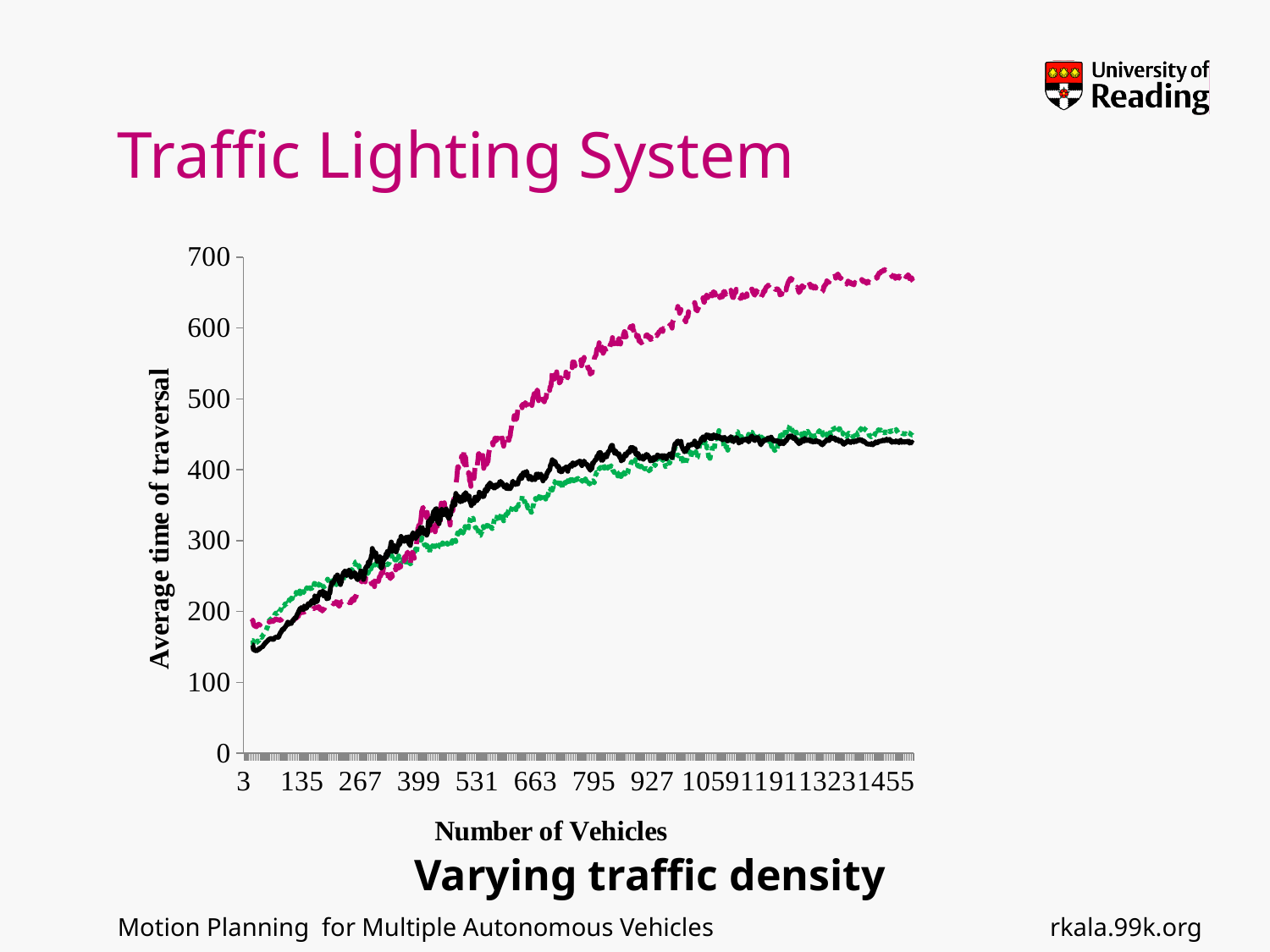
How many tick labels are shown on the x axis? 12 What is the title of the y axis? Average time of traversal Is the value of the green dotted line at 399 vehicles greater or less than 400? less Do the plotted values generally rise or fall as the number of vehicles increases? rise Is the value of the black solid line at 1455 vehicles greater or less than 500? less How many lines are plotted on the chart? 3 Is the value of the magenta dashed line at 1455 vehicles greater or less than 600? greater What is the title of the x axis? Number of Vehicles At 1455 vehicles, which is larger: the value of the magenta dashed line or the value of the black solid line? the magenta dashed line What kind of chart is shown on the slide? line chart Which line reaches the highest average time of traversal at the right end of the chart: the magenta dashed line, the green dotted line, or the black solid line? the magenta dashed line